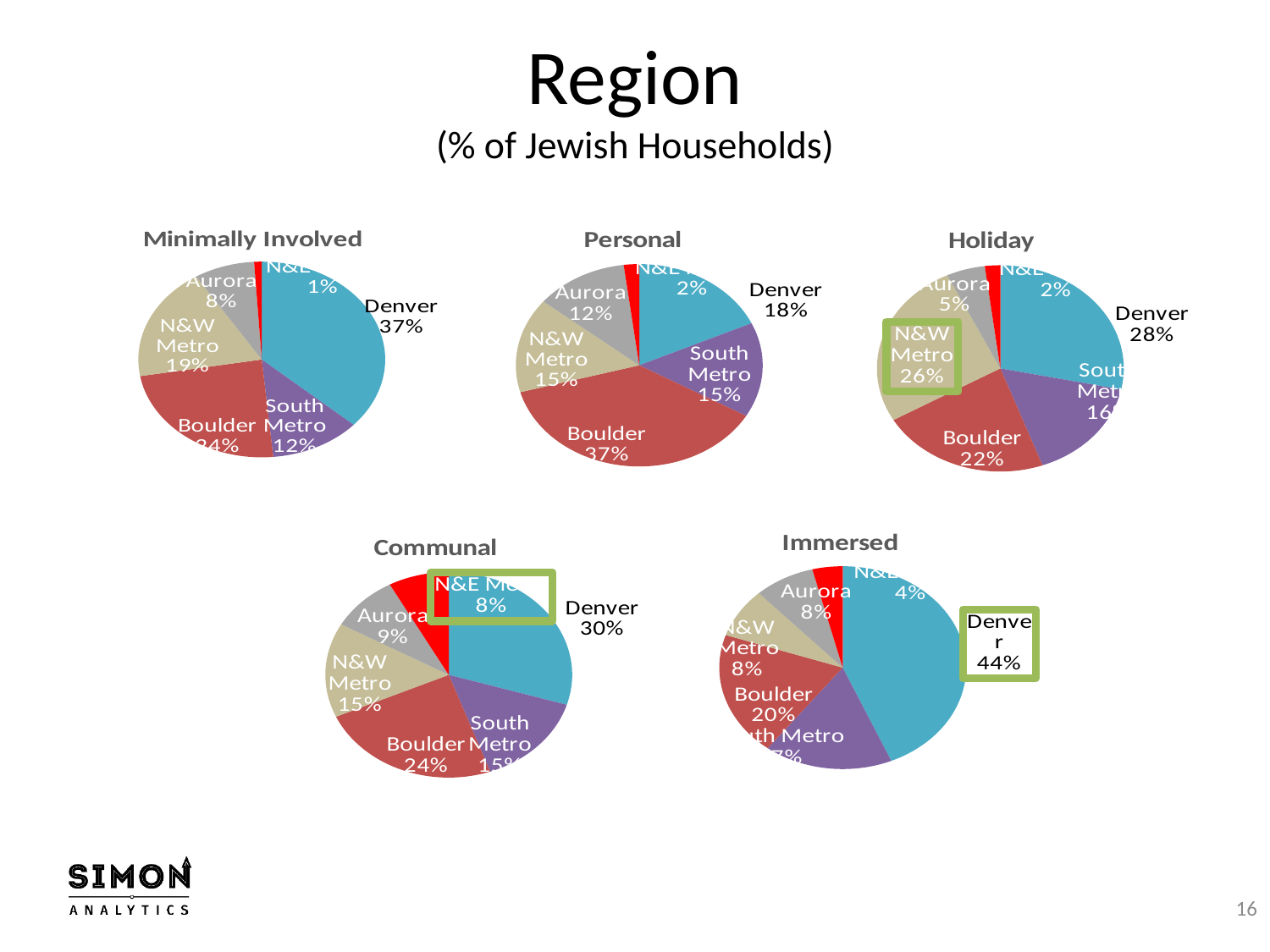
In the Personal pie chart, which region has the largest share? Boulder In the Minimally Involved pie chart, what percentage is Denver? 37% In the Communal pie chart, which is larger, Denver or Boulder? Denver In the Minimally Involved pie chart, which region has the smallest share? N&E Metro In the Personal pie chart, what percentage is Boulder? 37% What kind of chart is used for the Immersed group? Pie chart In the Holiday pie chart, what percentage is N&W Metro? 26% How many pie charts are on the slide? 5 In the Personal pie chart, what percentage is Aurora? 12% In the Holiday pie chart, what is the difference between Denver and Boulder? 6% In the Communal pie chart, what percentage is N&E Metro? 8% In the Immersed pie chart, what percentage is Denver? 44%